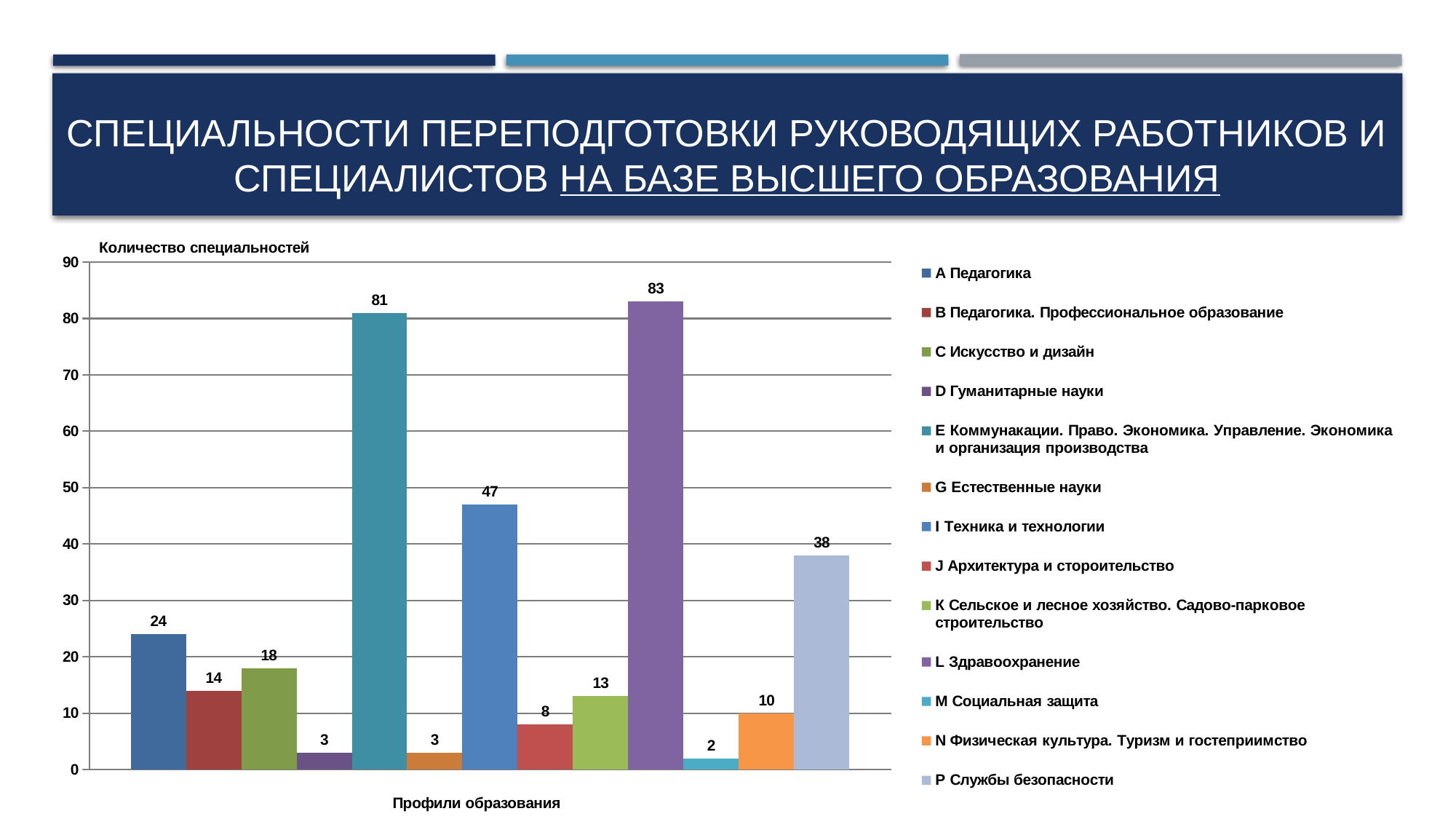
What is the value for P Службы безопасности? 38 What is the value for L Здравоохранение? 83 What is the label of the vertical axis? Количество специальностей Which category has the highest value? L Здравоохранение Which is larger, the value for C Искусство и дизайн or the value for B Педагогика. Профессиональное образование? C Искусство и дизайн What is the value for A Педагогика? 24 Is the value for I Техника и технологии greater or less than 40? greater How many bars are plotted in the chart? 13 What is the value for E Коммунакации. Право. Экономика. Управление. Экономика и организация производства? 81 Which category has the lowest value? M Социальная защита What kind of chart is shown on the slide? bar chart What is the difference between the values for I Техника и технологии and P Службы безопасности? 9